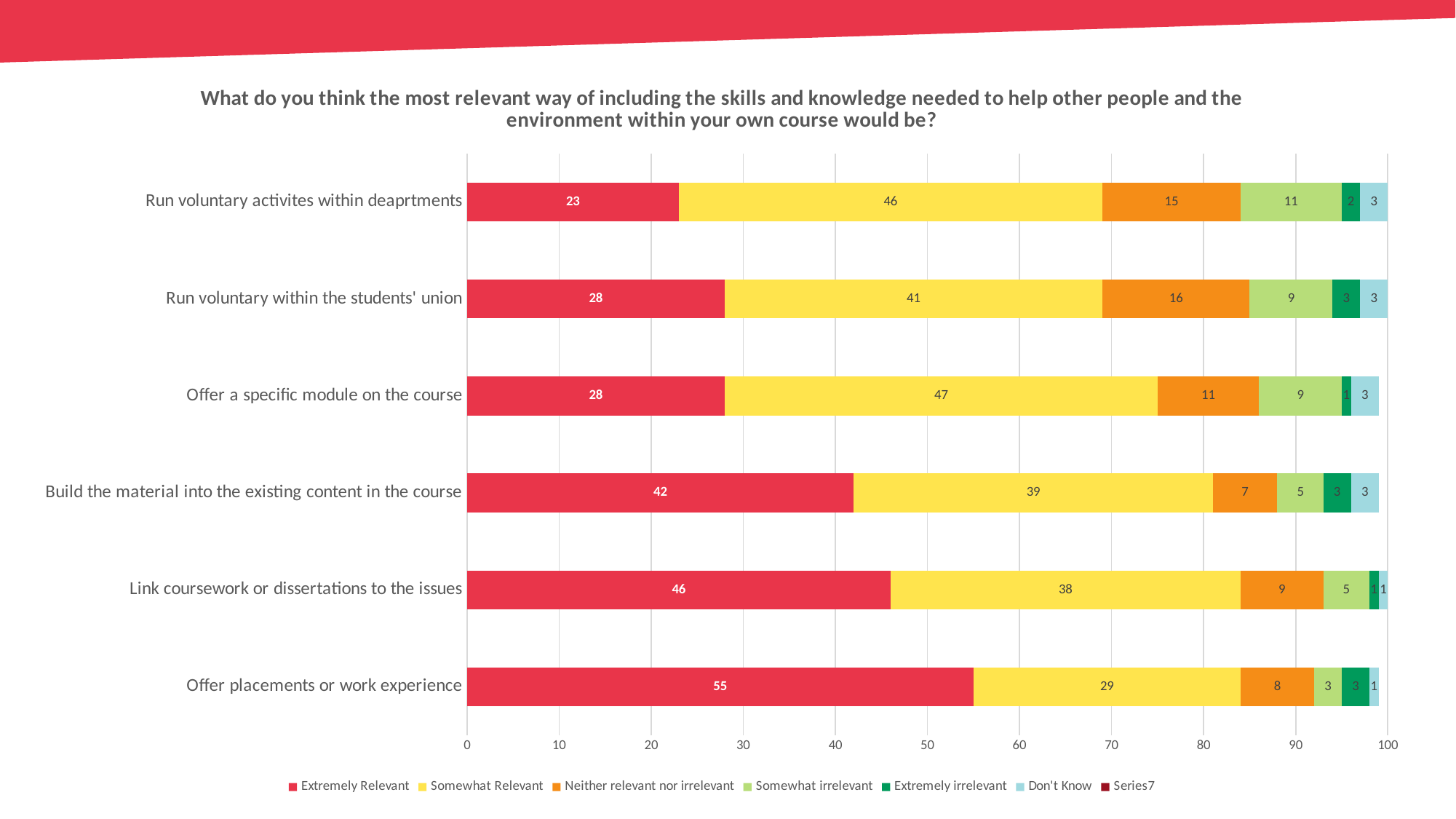
What is the Extremely Relevant value for "Offer placements or work experience"? 55 What is the total of the stacked bar for "Run voluntary within the students' union"? 100 How many categories are shown on the chart? 6 Which is larger: the Somewhat Relevant value for "Run voluntary activites within deaprtments" or for "Offer placements or work experience"? Run voluntary activites within deaprtments What is the difference between the Extremely Relevant values for "Link coursework or dissertations to the issues" and "Build the material into the existing content in the course"? 4 Which colour represents the Somewhat Relevant series in the legend? Yellow What kind of chart is shown on the slide? Stacked bar chart What is the Neither relevant nor irrelevant value for "Run voluntary within the students' union"? 16 Which category has the lowest Extremely Relevant value? Run voluntary activites within deaprtments Which category has the highest Extremely Relevant value? Offer placements or work experience How many series does the legend list? 7 What is the Somewhat Relevant value for "Offer a specific module on the course"? 47